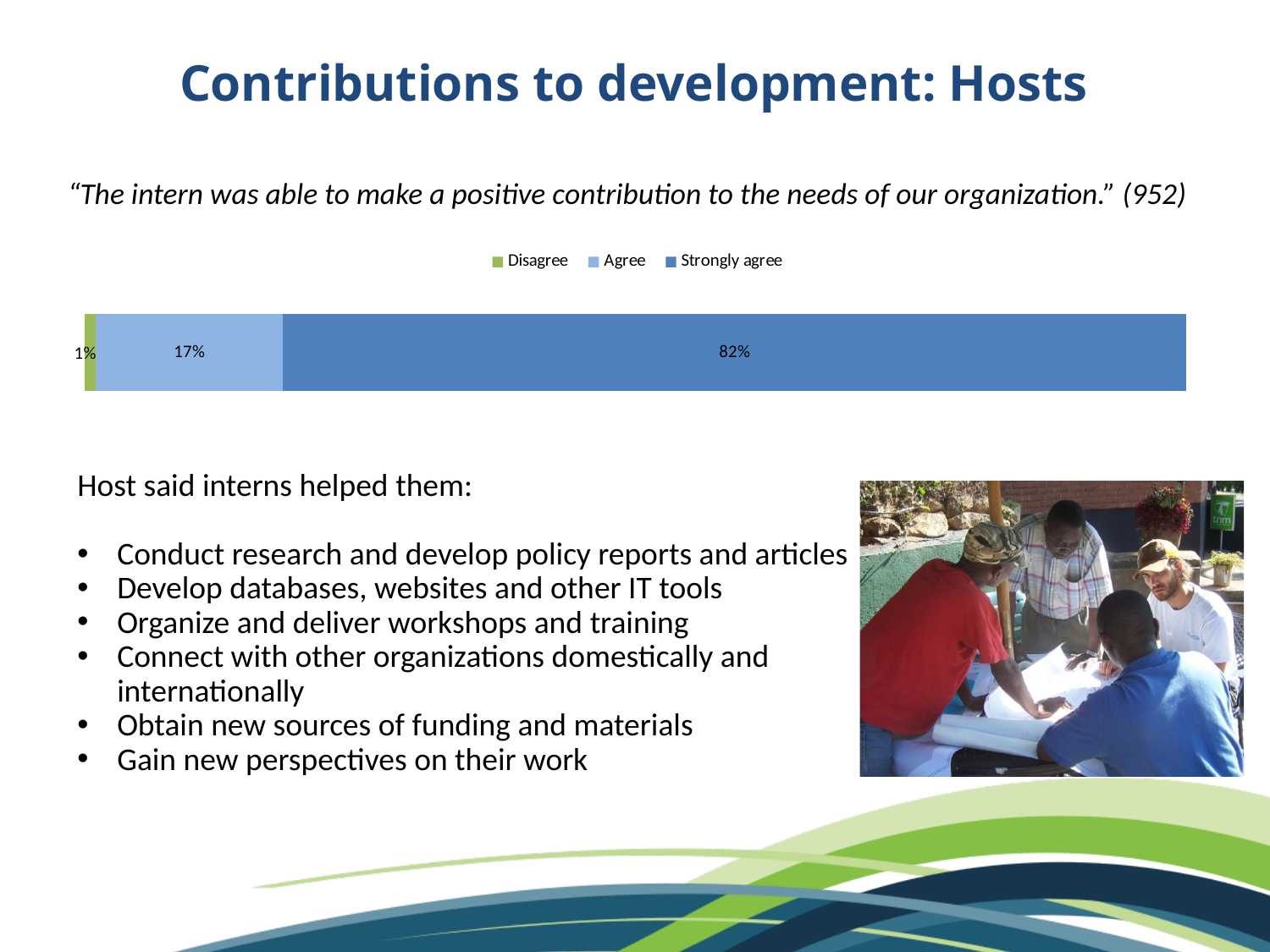
How many respondents does the survey statement above the chart indicate? 952 Which is larger, the share for Agree or the share for Disagree? Agree What percentage of hosts agreed (but not strongly) that the intern made a positive contribution? 17% What percentage of hosts strongly agreed that the intern made a positive contribution? 82% What percentage of hosts disagreed that the intern made a positive contribution? 1% What is the difference in percentage points between Strongly agree and Agree? 65 What colour is the Disagree segment in the chart? Green What kind of chart is shown on the slide? Stacked bar chart How many series does the legend list? 3 Which response category has the largest share in the chart? Strongly agree Which response category has the smallest share in the chart? Disagree What is the total of the three segments in the stacked bar? 100%